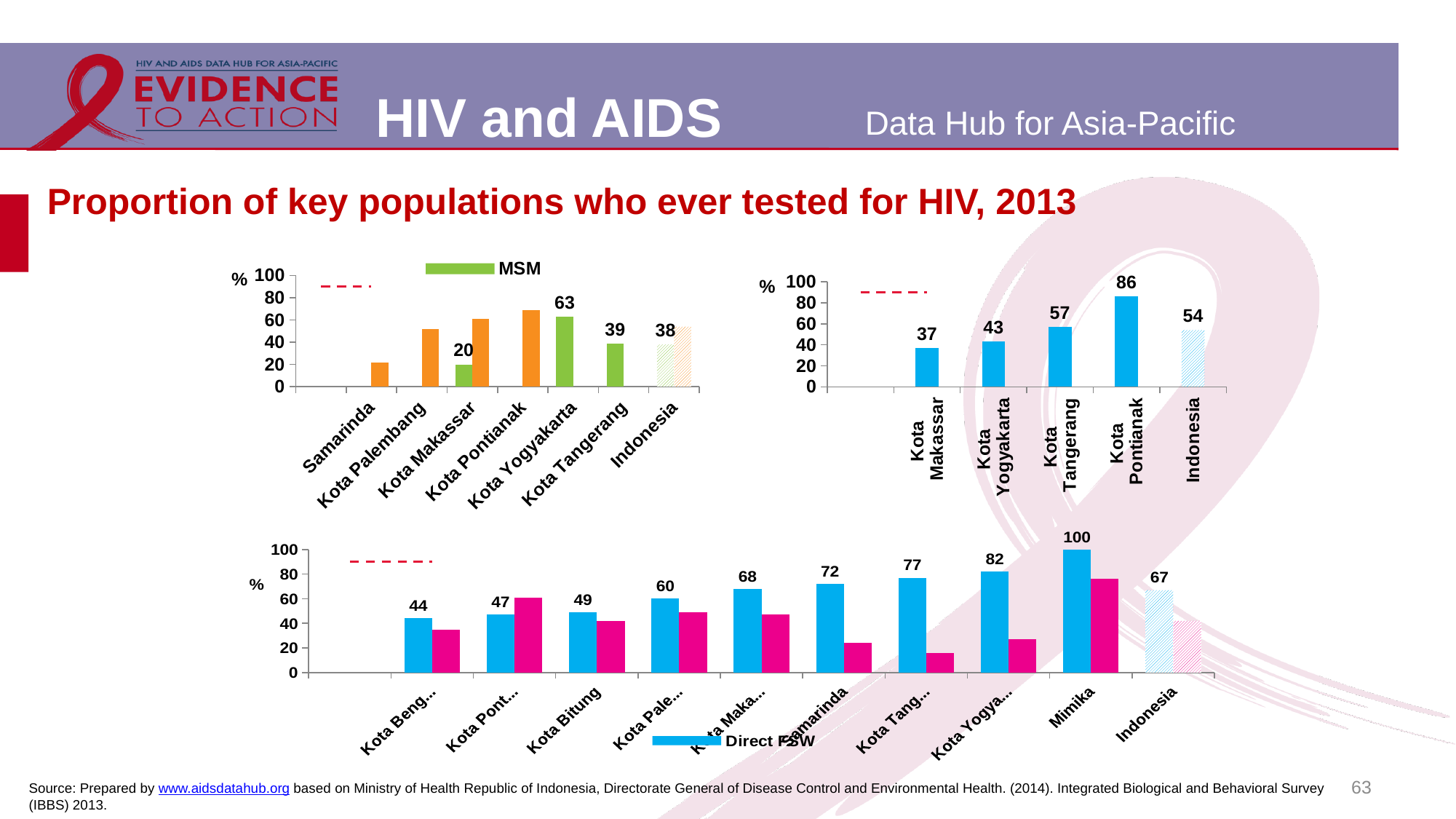
How many categories are shown in the top-right chart? 5 In the top-left chart, which is larger: the MSM value for Kota Makassar or for Kota Tangerang? Kota Tangerang In the top-right chart, what is the difference between the values for Kota Pontianak and Kota Makassar? 49 In the top-right chart, what is the value for Kota Pontianak? 86 In the bottom chart, which category has the highest Direct FSW value? Mimika In the top-left chart, is the orange bar for Samarinda greater or less than 40? less In the top-left chart, what is the MSM value for Kota Yogyakarta? 63 How many categories are shown on the x axis of the bottom chart? 10 In the top-right chart, which category has the highest value? Kota Pontianak In the bottom chart, what is the Direct FSW value for Kota Bitung? 49 In the bottom chart, what is the Direct FSW value for Mimika? 100 In the top-right chart, which category has the lowest value? Kota Makassar